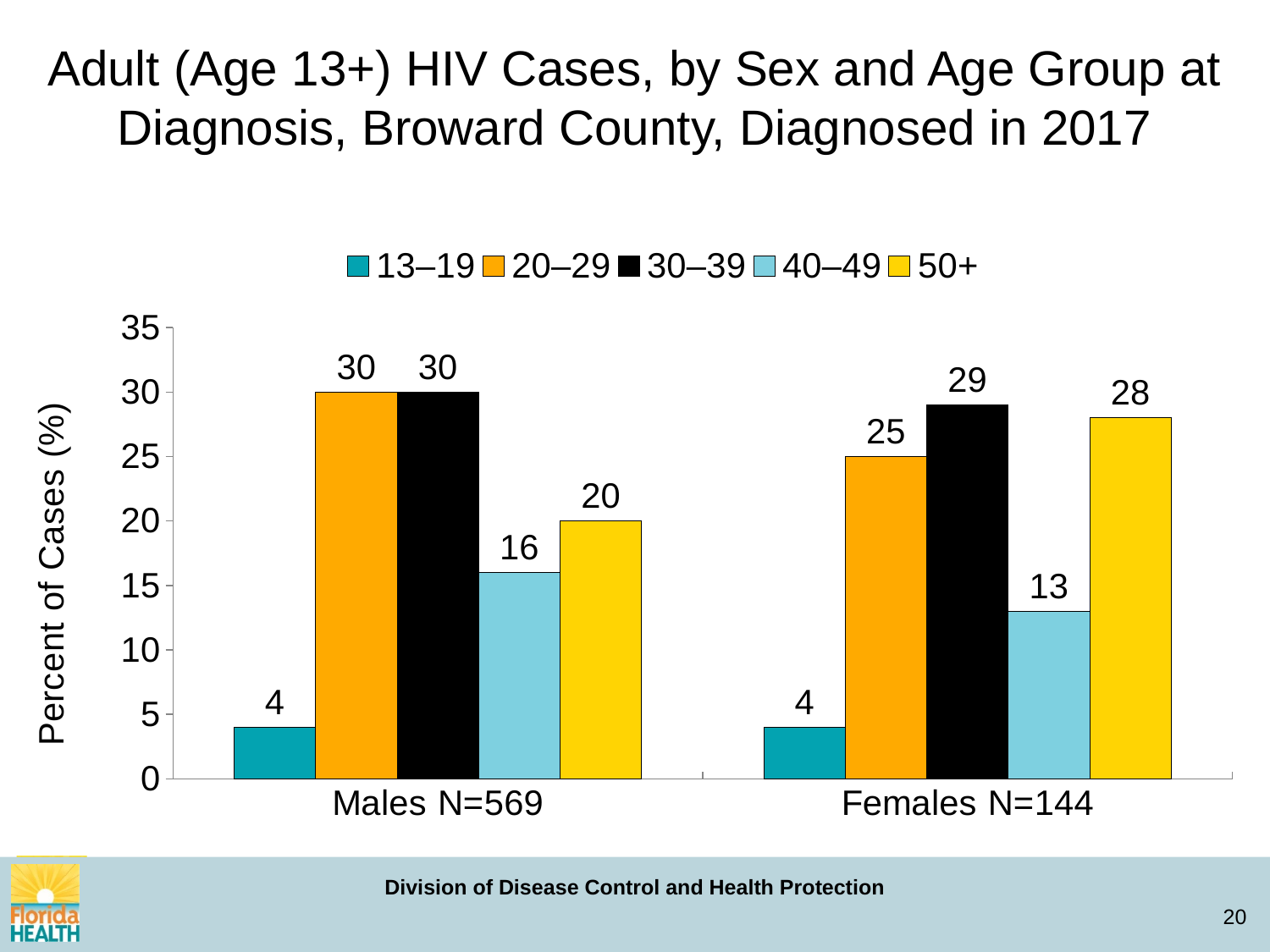
What kind of chart is shown on the slide? Bar chart Which age group has the lowest percent of cases among males? 13–19 How many age groups does the legend list? 5 Which age group has the highest percent of cases among females? 30–39 What is the difference between the 50+ percentage for females and for males? 8 How many sex categories are shown on the x axis? 2 What is the label of the y axis? Percent of Cases (%) What percent of male cases were in the 40–49 age group? 16 What percent of female cases were in the 20–29 age group? 25 What percent of female cases were in the 50+ age group? 28 Which is larger: the 20–29 percentage for males or for females? Males What is the N shown for females? 144